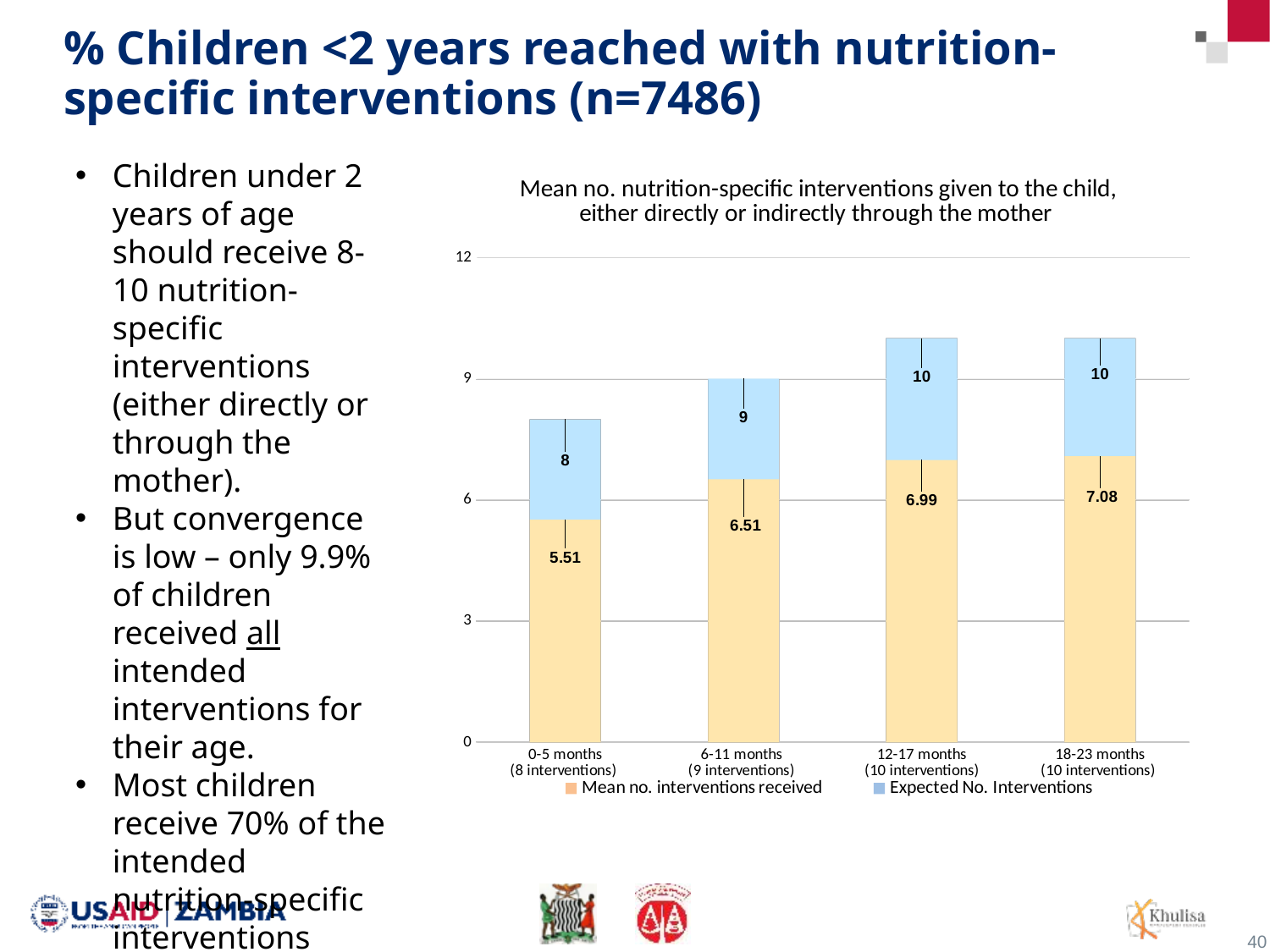
What is the difference between the expected number of interventions and the mean number received for the 0-5 months group? 2.49 Which age group has the lowest mean number of interventions received? 0-5 months What is the difference between the expected number of interventions and the mean number received for the 12-17 months group? 3.01 What is the expected number of interventions for the 6-11 months group? 9 How many series does the chart legend list? 2 Is the mean number of interventions received for the 0-5 months group greater or less than 6? less What is the mean number of interventions received for children aged 18-23 months? 7.08 Does the mean number of interventions received rise or fall as age group increases along the x axis? rise What is the mean number of interventions received for children aged 0-5 months? 5.51 Which age group has the highest mean number of interventions received? 18-23 months How many age groups are shown on the x axis of the chart? 4 Which is larger: the mean number of interventions received for 6-11 months or for 12-17 months? 12-17 months